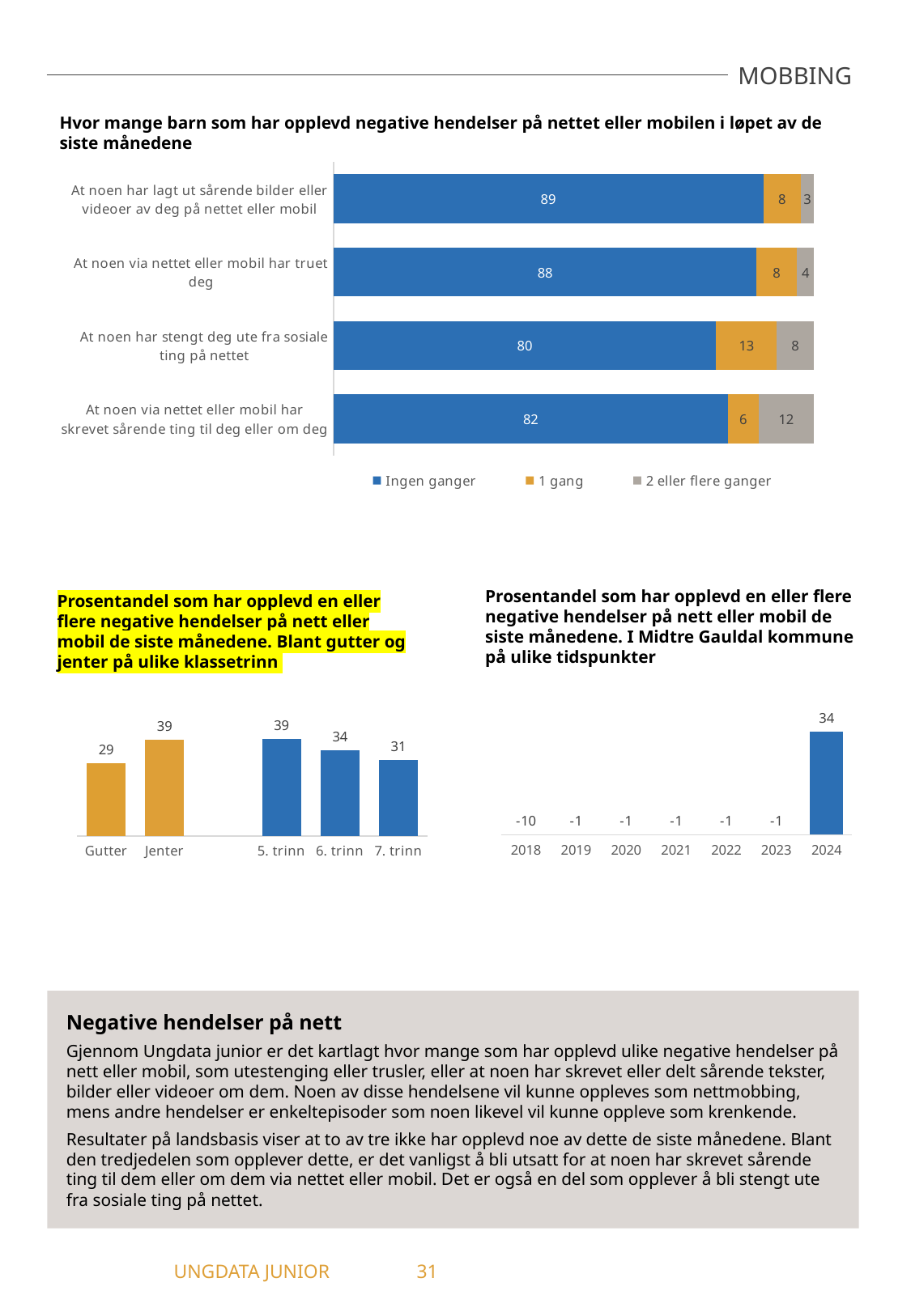
In the top chart 'Hvor mange barn som har opplevd negative hendelser på nettet eller mobilen i løpet av de siste månedene', what is the 'Ingen ganger' value for 'At noen har stengt deg ute fra sosiale ting på nettet'? 80 In the bottom-left chart, do the values rise or fall from 5. trinn to 7. trinn? fall In the top chart, what is the total of the stacked bar for 'At noen via nettet eller mobil har truet deg'? 100 In the top chart, which category has the highest '1 gang' value? At noen har stengt deg ute fra sosiale ting på nettet In the bottom-left chart, which is larger, the value for Jenter or the value for Gutter? Jenter In the top chart, which category has the highest 'Ingen ganger' value? At noen har lagt ut sårende bilder eller videoer av deg på nettet eller mobil In the bottom-right chart 'Prosentandel ... I Midtre Gauldal kommune på ulike tidspunkter', what is the value for 2024? 34 In the top chart, how many series does the legend list? 3 In the bottom-right chart, how many years are shown on the x axis? 7 In the top chart, what is the difference between the '2 eller flere ganger' values for 'At noen har stengt deg ute fra sosiale ting på nettet' and 'At noen har lagt ut sårende bilder eller videoer av deg på nettet eller mobil'? 5 In the bottom-left chart 'Prosentandel som har opplevd en eller flere negative hendelser ... Blant gutter og jenter på ulike klassetrinn', what is the value for Gutter? 29 In the top chart, what is the '2 eller flere ganger' value for 'At noen via nettet eller mobil har skrevet sårende ting til deg eller om deg'? 12